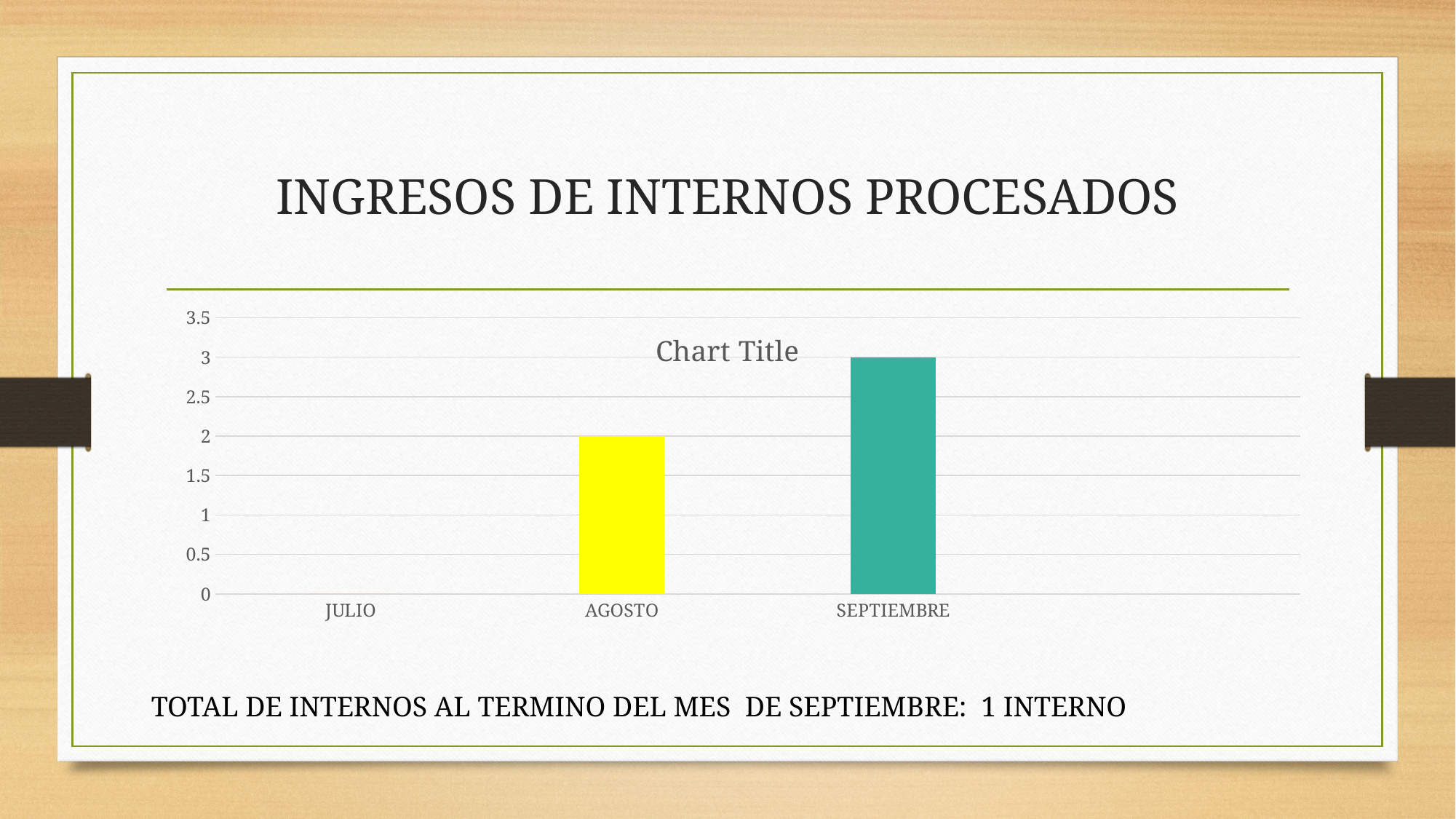
What is the value for SEPTIEMBRE? 3 What colour is the bar for AGOSTO? yellow Which category has the lowest value? JULIO What is the value for AGOSTO? 2 How many categories are shown on the x axis? 3 Which category has the highest value? SEPTIEMBRE Is the value for SEPTIEMBRE greater or less than 2.5? greater Is the value for AGOSTO greater or less than 2.5? less What is the difference between the values for SEPTIEMBRE and AGOSTO? 1 What kind of chart is shown on the slide? bar chart Do the values rise or fall from JULIO to SEPTIEMBRE? rise Which is larger, the value for AGOSTO or the value for SEPTIEMBRE? SEPTIEMBRE